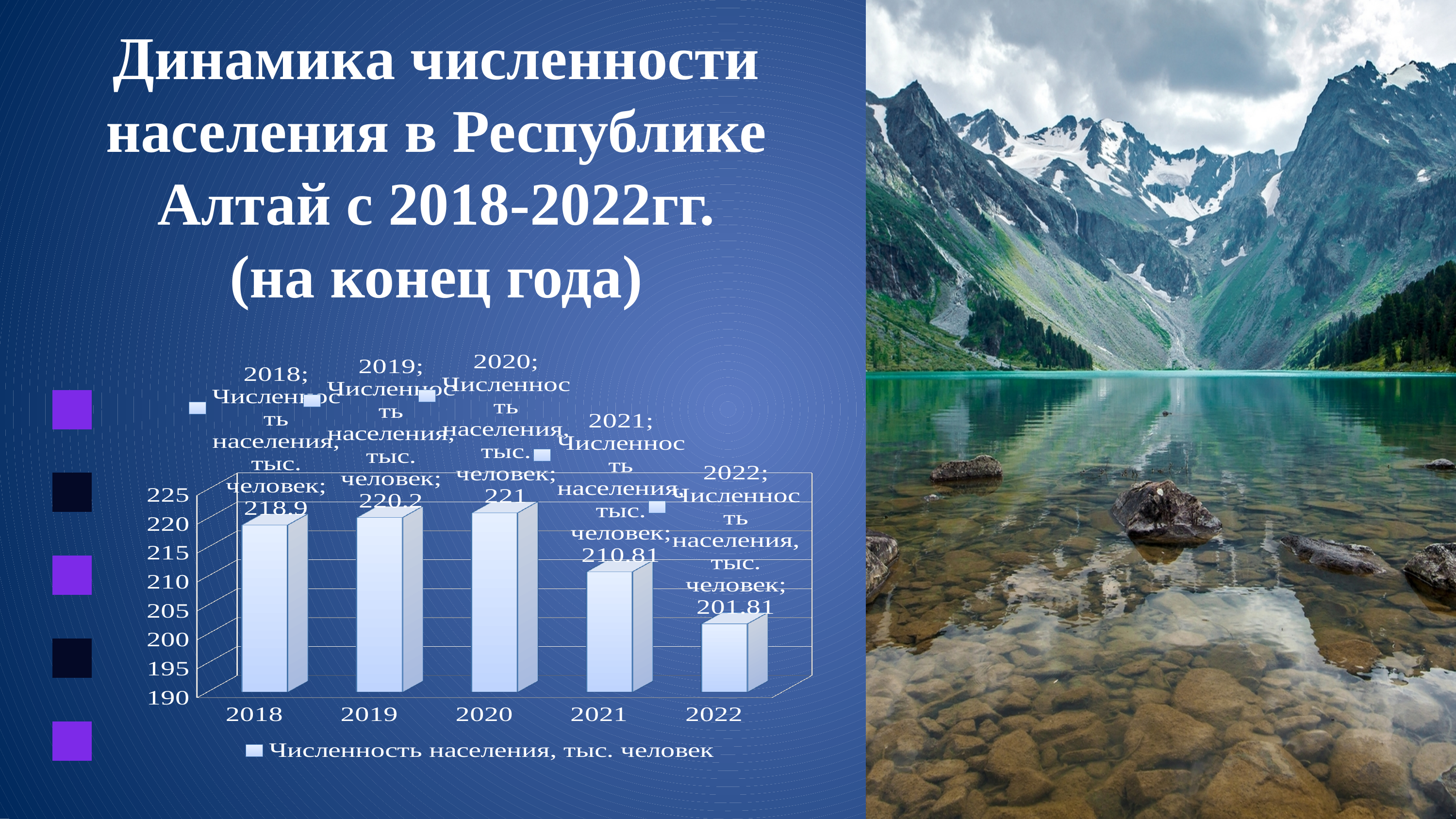
What is the population value shown for 2022? 201.81 Which year has the highest population value? 2020 What series name does the legend show? Численность населения, тыс. человек What is the difference between the 2020 value and the 2022 value? 19.19 Which is larger, the value for 2019 or the value for 2021? 2019 Which year has the lowest population value? 2022 How many years are shown on the x axis? 5 What is the population value shown for 2021? 210.81 What kind of chart is shown on the slide? bar chart Is the value for 2022 greater or less than 205? less What is the population value shown for 2018? 218.9 What is the difference between the 2019 value and the 2018 value? 1.3